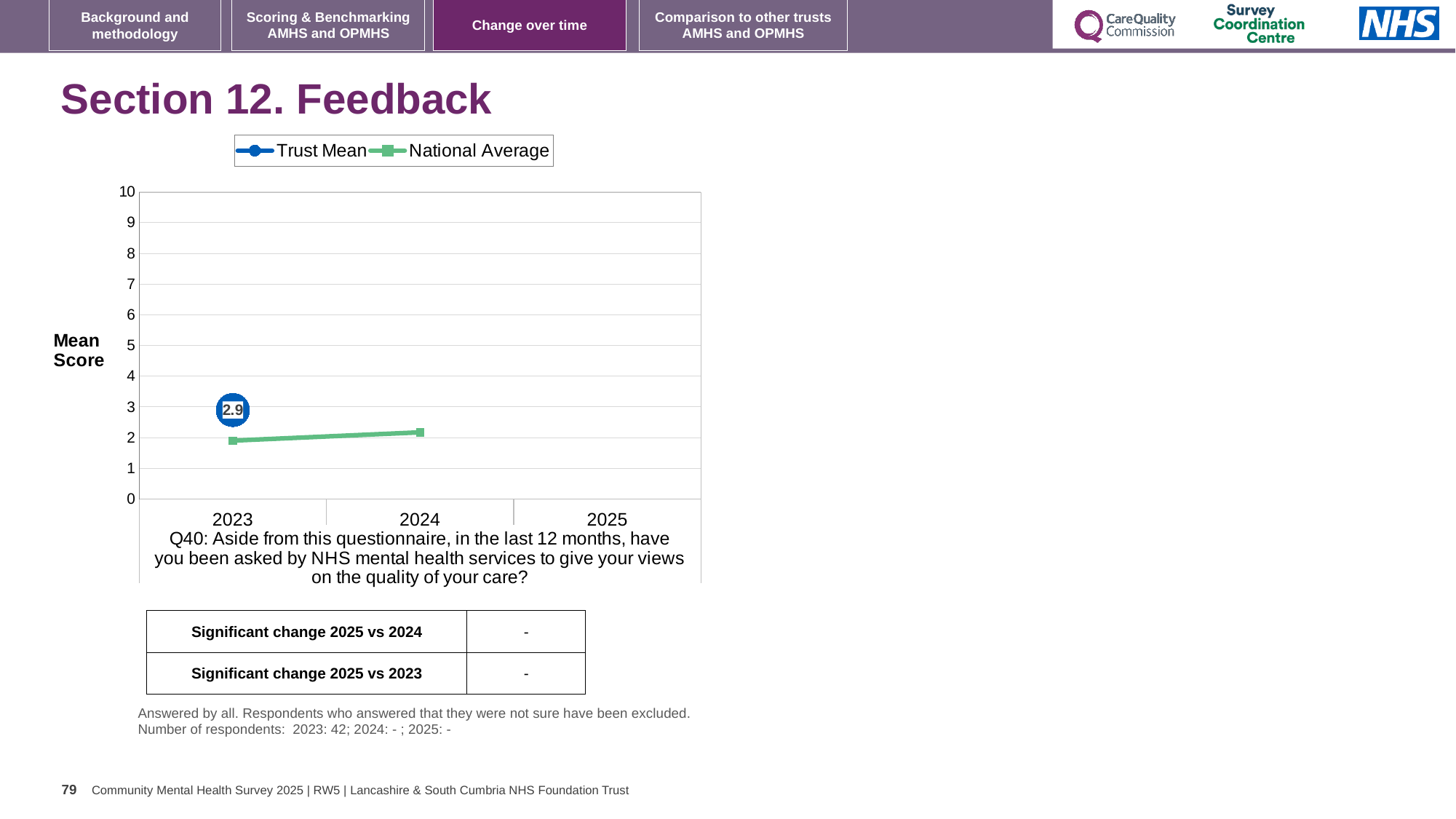
How many series does the legend list? 2 Is the National Average value for 2024 greater or less than 3? less Is the National Average value for 2023 greater or less than 3? less How many years are shown on the x axis? 3 Is the National Average value for 2023 greater or less than 1? greater What kind of chart is shown on the slide? line chart Which year has the higher plotted National Average value, 2023 or 2024? 2024 What are the two series named in the legend? Trust Mean and National Average What is the label on the y axis of the chart? Mean Score What is the Trust Mean value for 2023? 2.9 In 2023, which is larger: the Trust Mean or the National Average? Trust Mean Does the National Average rise or fall from 2023 to 2024? rise